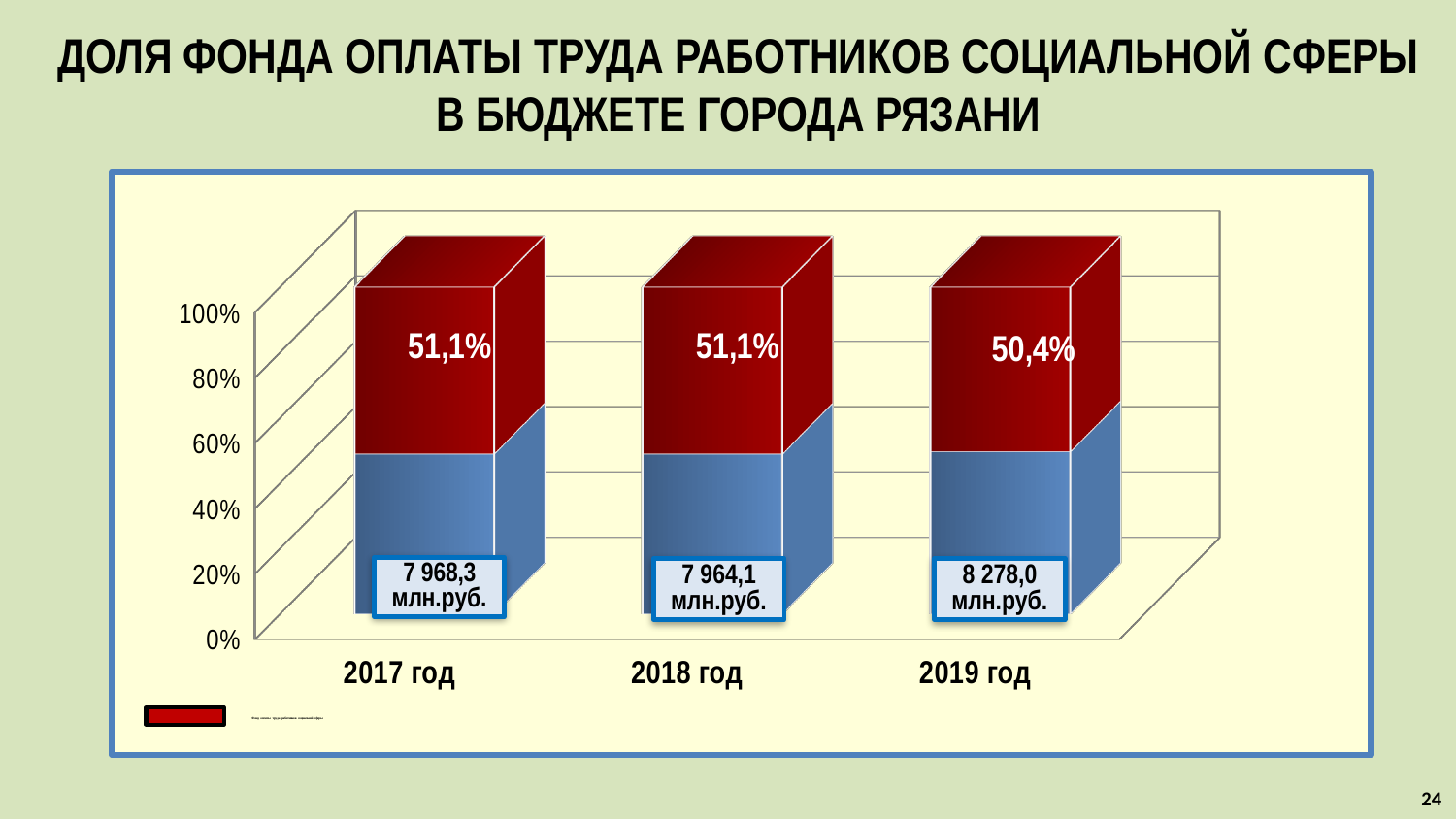
What amount in млн.руб. is labelled on the bar for 2018 год? 7 964,1 млн.руб. What kind of chart is shown on the slide? Stacked bar chart What is the difference between the млн.руб. amount for 2019 год and the amount for 2017 год? 309,7 млн.руб. What amount in млн.руб. is labelled on the bar for 2019 год? 8 278,0 млн.руб. What percentage is shown on the red segment for 2017 год? 51,1% Which is larger, the млн.руб. amount for 2017 год or for 2019 год? 2019 год What is the title of the slide? ДОЛЯ ФОНДА ОПЛАТЫ ТРУДА РАБОТНИКОВ СОЦИАЛЬНОЙ СФЕРЫ В БЮДЖЕТЕ ГОРОДА РЯЗАНИ What percentage is shown on the red segment for 2019 год? 50,4% Which year has the lowest percentage shown on its red segment? 2019 год How many years (categories) are shown on the x axis of the chart? 3 What is the difference between the percentage shown for 2017 год and the percentage shown for 2019 год? 0,7% Which year has the highest amount in млн.руб. labelled on its bar? 2019 год